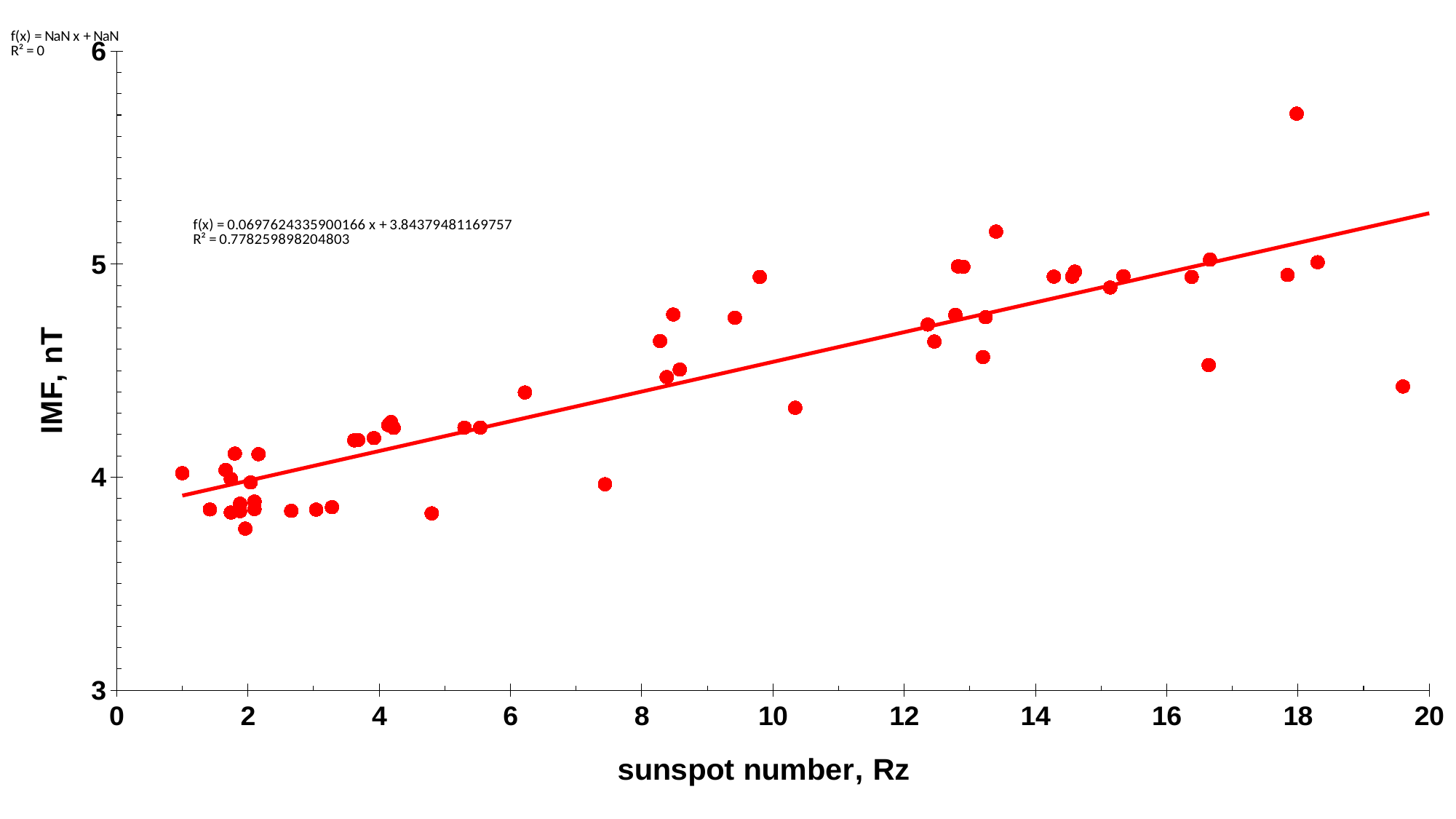
Is the IMF value of the lowest plotted point greater or less than 4? less Is the IMF value of the point near sunspot number 10 (around 10.3) greater or less than 4.5? less What is the maximum value shown on the y axis? 6 What is the label of the x axis? sunspot number, Rz What is the maximum value shown on the x axis? 20 Do the IMF values generally rise or fall as the sunspot number increases along the x axis? rise Is the IMF value of the highest plotted point greater or less than 5? greater What kind of chart is shown on the slide? scatter plot